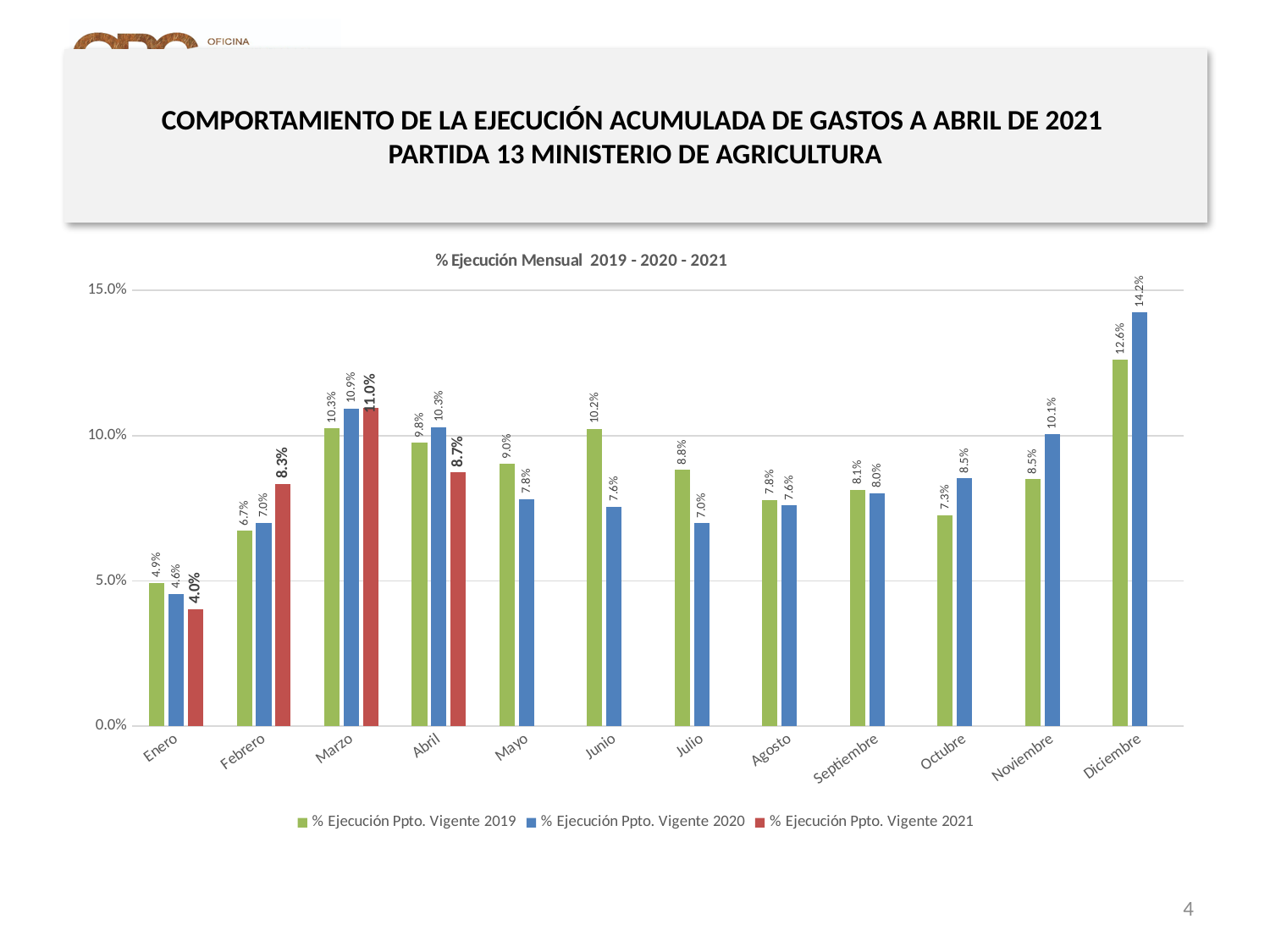
Which month has the highest value for % Ejecución Ppto. Vigente 2019? Diciembre What is the value for % Ejecución Ppto. Vigente 2019 in Junio? 10.2% Is the value for % Ejecución Ppto. Vigente 2019 in Noviembre greater or less than 10.0%? less What is the difference between the 2020 and 2019 values in Diciembre? 1.6% In Abril, which is larger: the 2020 value or the 2021 value? 2020 value (10.3%) What type of chart is shown on the slide? bar chart What is the value for % Ejecución Ppto. Vigente 2020 in Diciembre? 14.2% What is the title of the chart? % Ejecución Mensual 2019 - 2020 - 2021 How many series does the legend list? 3 What is the value for % Ejecución Ppto. Vigente 2021 in Marzo? 11.0% Which month has the lowest value for % Ejecución Ppto. Vigente 2021? Enero How many months are shown on the x axis? 12